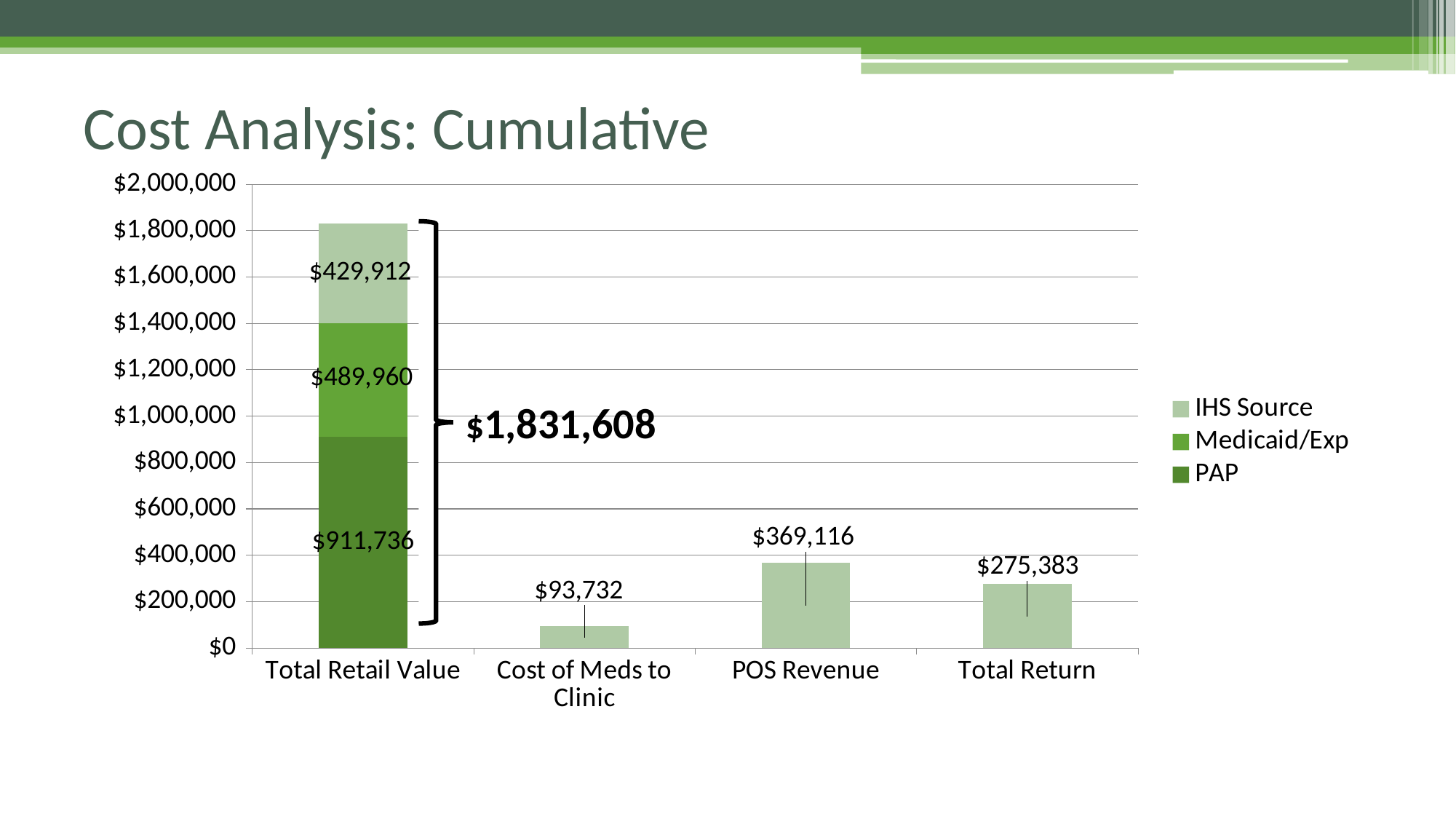
Which category has the lowest value? Cost of Meds to Clinic What kind of chart is shown on the slide? Stacked bar chart What is the value shown for POS Revenue? $369,116 Which is larger, POS Revenue or Total Return? POS Revenue What is the value shown for Cost of Meds to Clinic? $93,732 Which category has the highest total value? Total Retail Value What is the PAP value for Total Retail Value? $911,736 What is the Medicaid/Exp value for Total Retail Value? $489,960 What is the total of the stacked Total Retail Value bar? $1,831,608 How many series does the legend list? 3 What is the IHS Source value for Total Retail Value? $429,912 What is the difference between POS Revenue and Total Return? $93,733